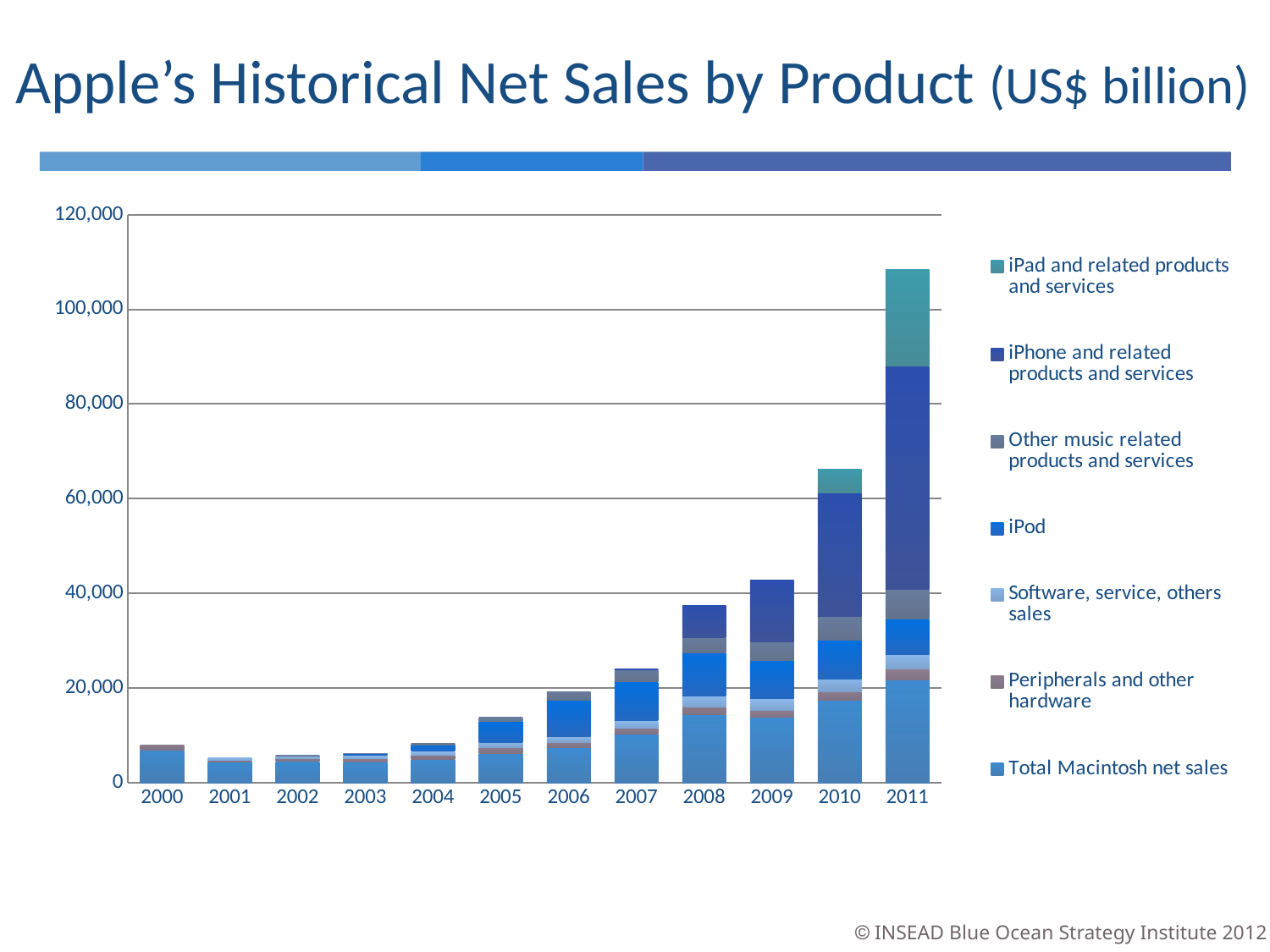
Which year has the highest total net sales? 2011 Which year has larger total net sales, 2010 or 2011? 2011 How many product series does the legend list? 7 Is the total net sales for 2010 greater or less than 60,000? greater Is the total net sales for 2000 greater or less than 20,000? less Which series is listed at the bottom of the legend? Total Macintosh net sales What kind of chart is shown on the slide? Stacked bar chart Is the total net sales for 2011 greater or less than 100,000? greater How many years are shown along the x axis of the chart? 12 Do total net sales generally rise or fall from 2000 to 2011? rise